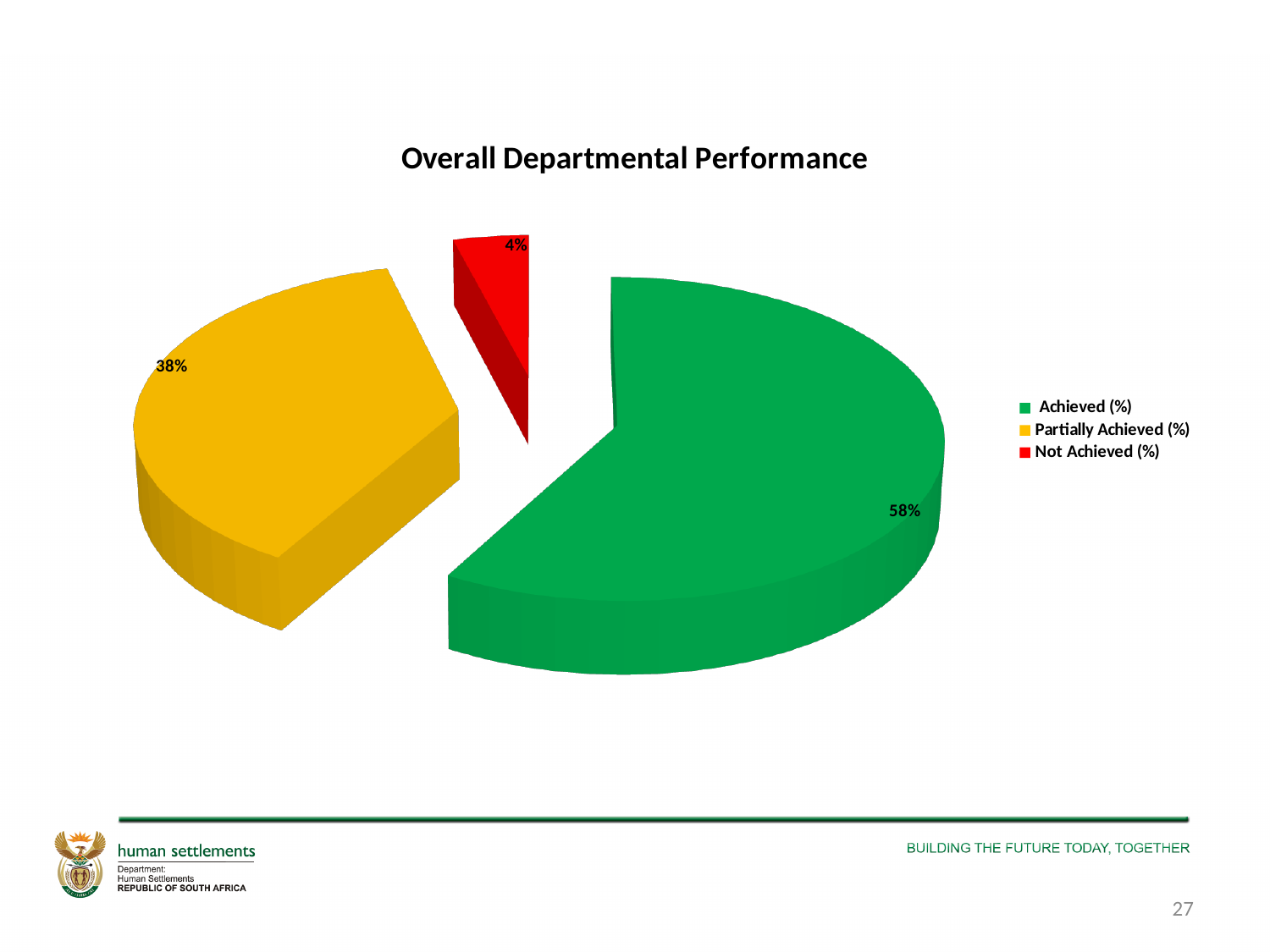
Which is larger, the share for Partially Achieved (%) or the share for Not Achieved (%)? Partially Achieved (%) How many categories does the legend list? 3 What kind of chart is shown on the slide? pie chart What is the difference in percentage points between Achieved (%) and Partially Achieved (%)? 20 What is the difference in percentage points between Partially Achieved (%) and Not Achieved (%)? 34 What percentage of the pie is labelled Not Achieved (%)? 4% What colour is the Not Achieved (%) slice? red What percentage of the pie is labelled Partially Achieved (%)? 38% What percentage of the pie is labelled Achieved (%)? 58% Which category has the smallest share of the pie? Not Achieved (%) What is the title of the chart? Overall Departmental Performance Which category has the largest share of the pie? Achieved (%)